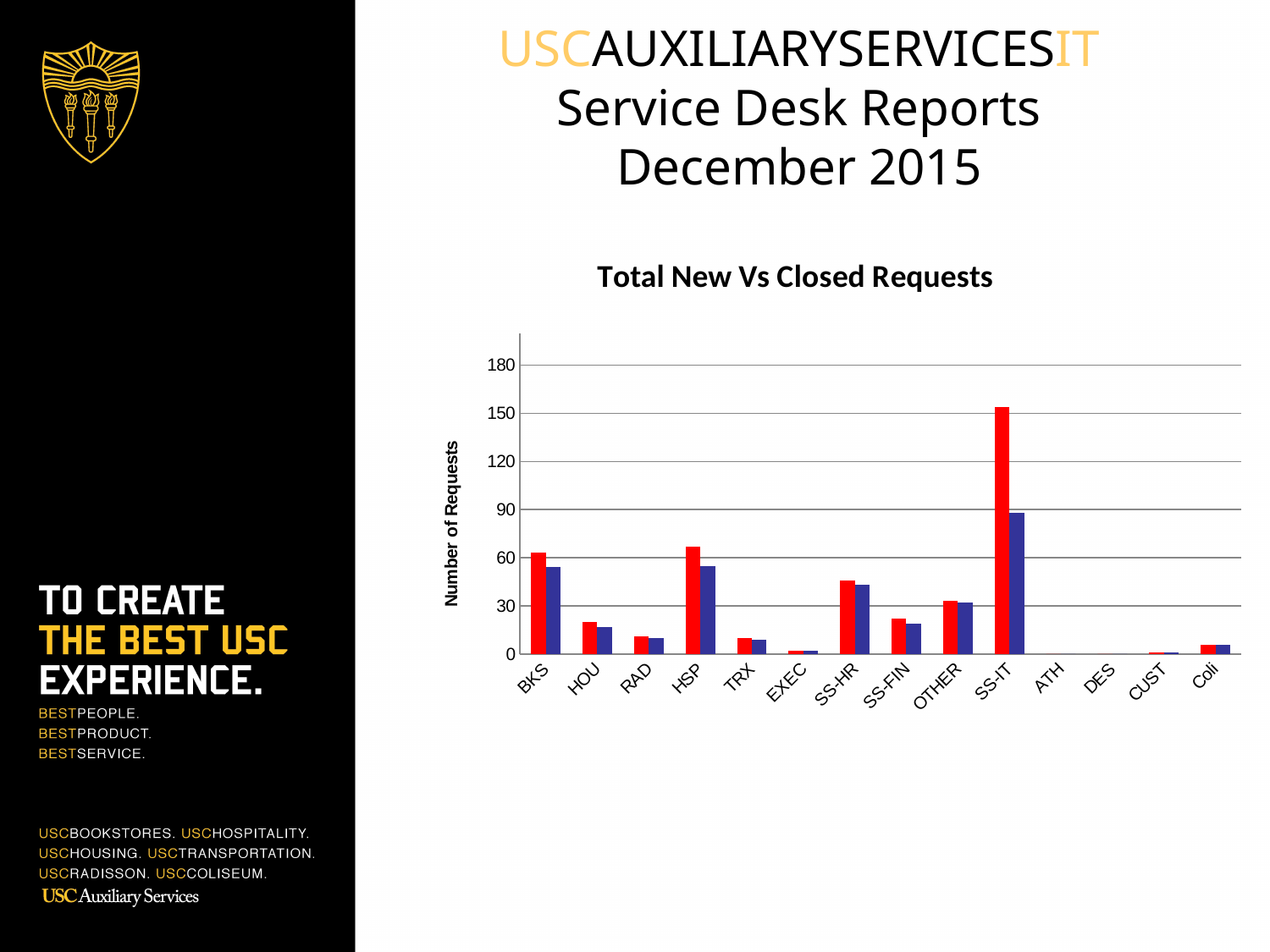
Is the value of the red bar for SS-FIN greater or less than 30? less What is the label on the vertical axis of the chart? Number of Requests What is the title of the chart? Total New Vs Closed Requests Is the value of the blue bar for SS-IT greater or less than 60? greater Is the value of the red bar for SS-IT greater or less than 120? greater For SS-IT, which bar is larger, the red bar or the blue bar? the red bar Which category has the highest bar in the chart? SS-IT How many categories are shown along the x axis of the chart? 14 Which has the larger red bar, BKS or HOU? BKS What type of chart is shown on the slide? bar chart